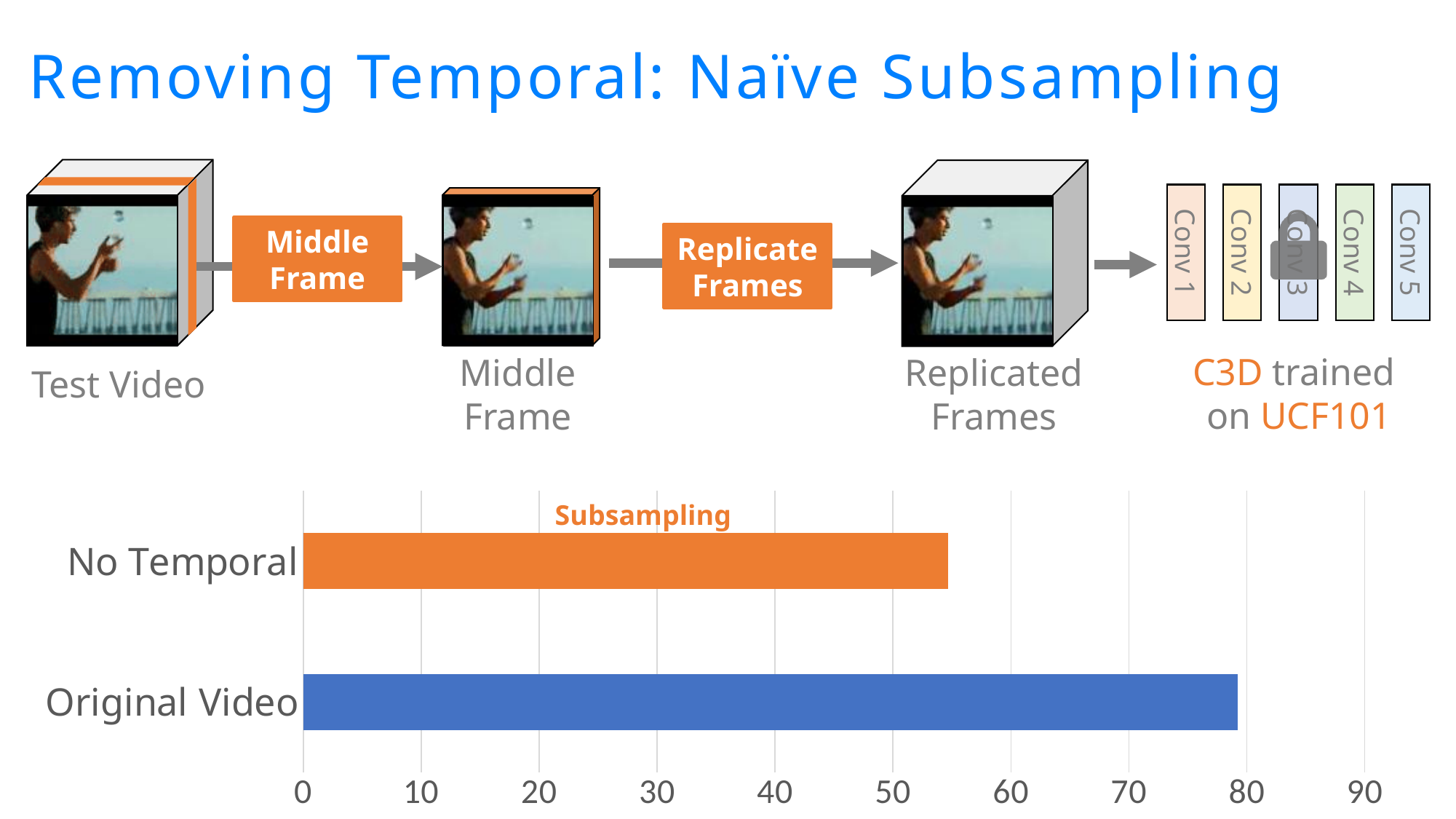
What kind of chart is shown on the slide? bar chart Is the value for No Temporal greater or less than 60? less How many categories does the bar chart show? 2 Is the value for Original Video greater or less than 70? greater What is the highest tick value shown on the x axis of the bar chart? 90 Which is larger, the value for No Temporal or the value for Original Video? Original Video Which category has the lowest value in the bar chart? No Temporal Is the value for No Temporal greater or less than 50? greater What label is printed above the No Temporal bar? Subsampling Which category has the highest value in the bar chart? Original Video